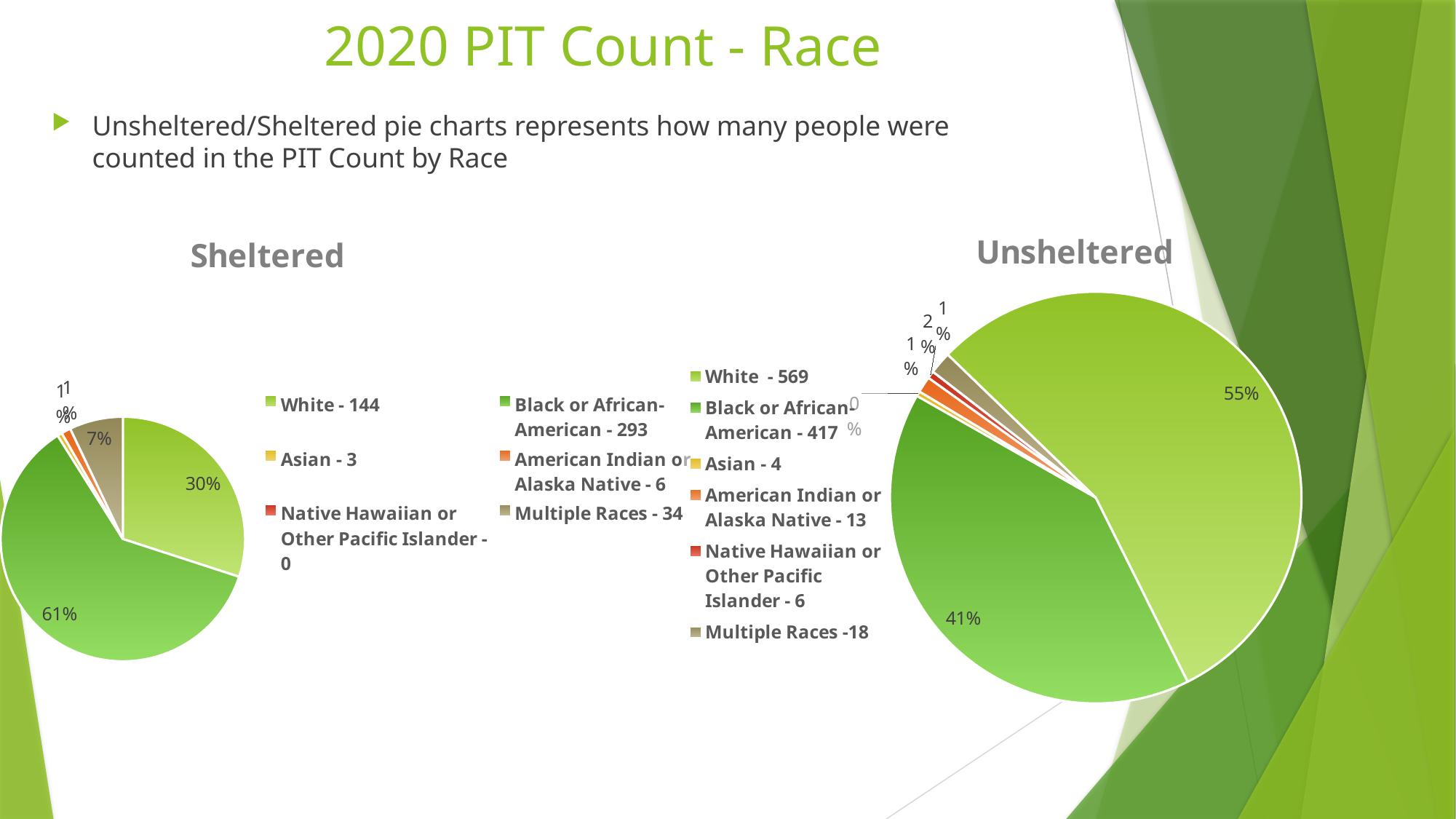
In the Sheltered chart, how many people are listed in the legend for Multiple Races? 34 In the Sheltered chart, which race has the largest slice? Black or African-American What kind of chart is the Sheltered chart? pie chart In the Sheltered chart, what share of the pie is Multiple Races? 7% In the Unsheltered chart, what share of the pie is Black or African-American? 41% In the Unsheltered chart, what share of the pie is White? 55% How many race categories does the legend of the Unsheltered chart list? 6 In the Unsheltered chart, which race has the largest slice? White In the Unsheltered chart, what is the difference between the White count (569) and the Black or African-American count (417) shown in the legend? 152 In the Unsheltered chart, how many people are listed in the legend for Black or African-American? 417